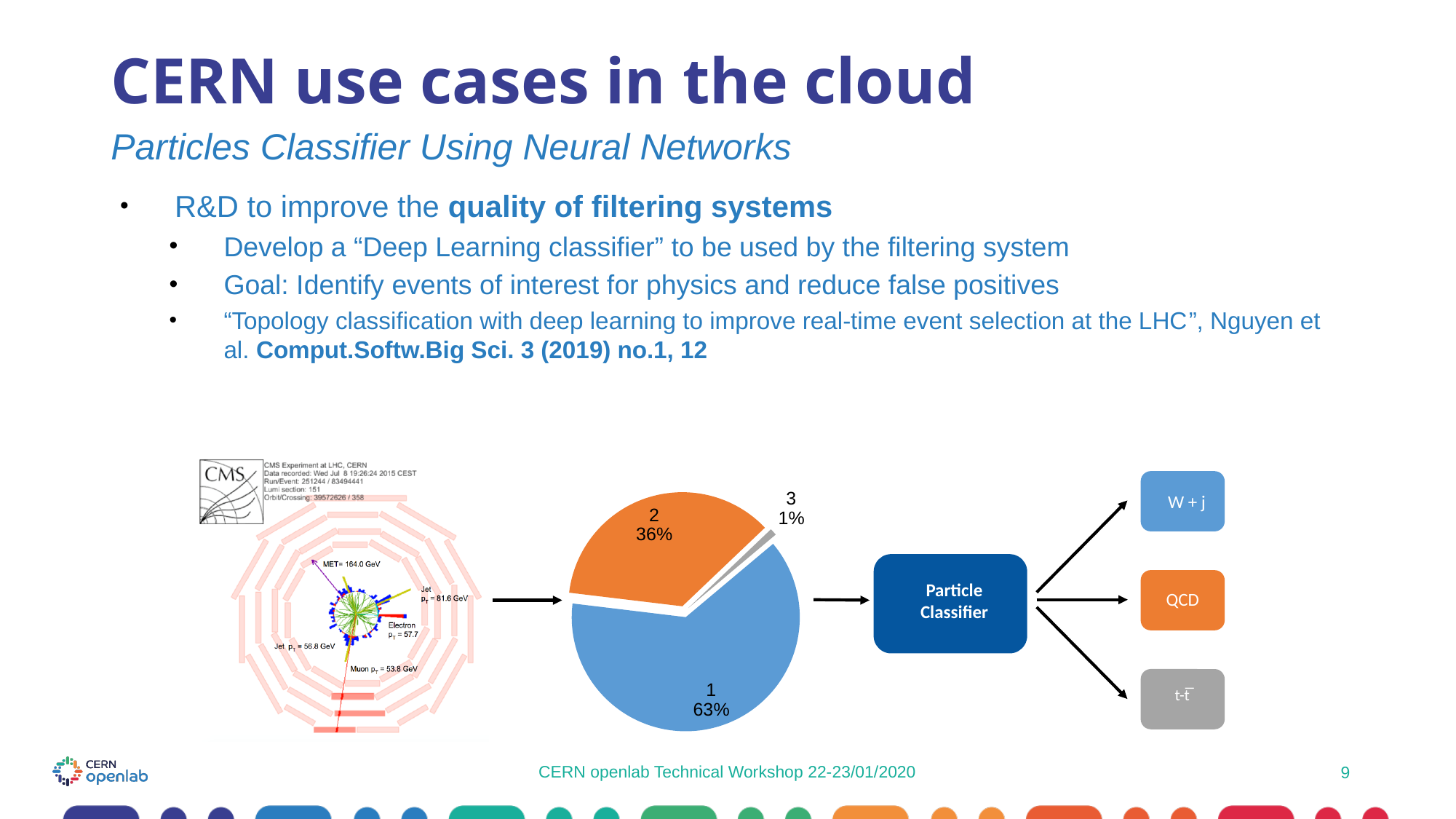
How many slices does the pie chart have? 3 In the pie chart, what is the difference in percentage points between slice 1 and slice 2? 27 Which slice of the pie chart is the largest? 1 In the pie chart, what share does slice 1 have? 63% In the pie chart, is the share of slice 1 greater or less than 50%? greater In the pie chart, which is larger, slice 2 or slice 3? 2 What kind of chart is shown in the middle of the slide? pie chart Which slice of the pie chart is the smallest? 3 What colour is slice 2 in the pie chart? orange In the pie chart, what share does slice 2 have? 36% What colour is slice 1 in the pie chart? blue In the pie chart, what share does slice 3 have? 1%